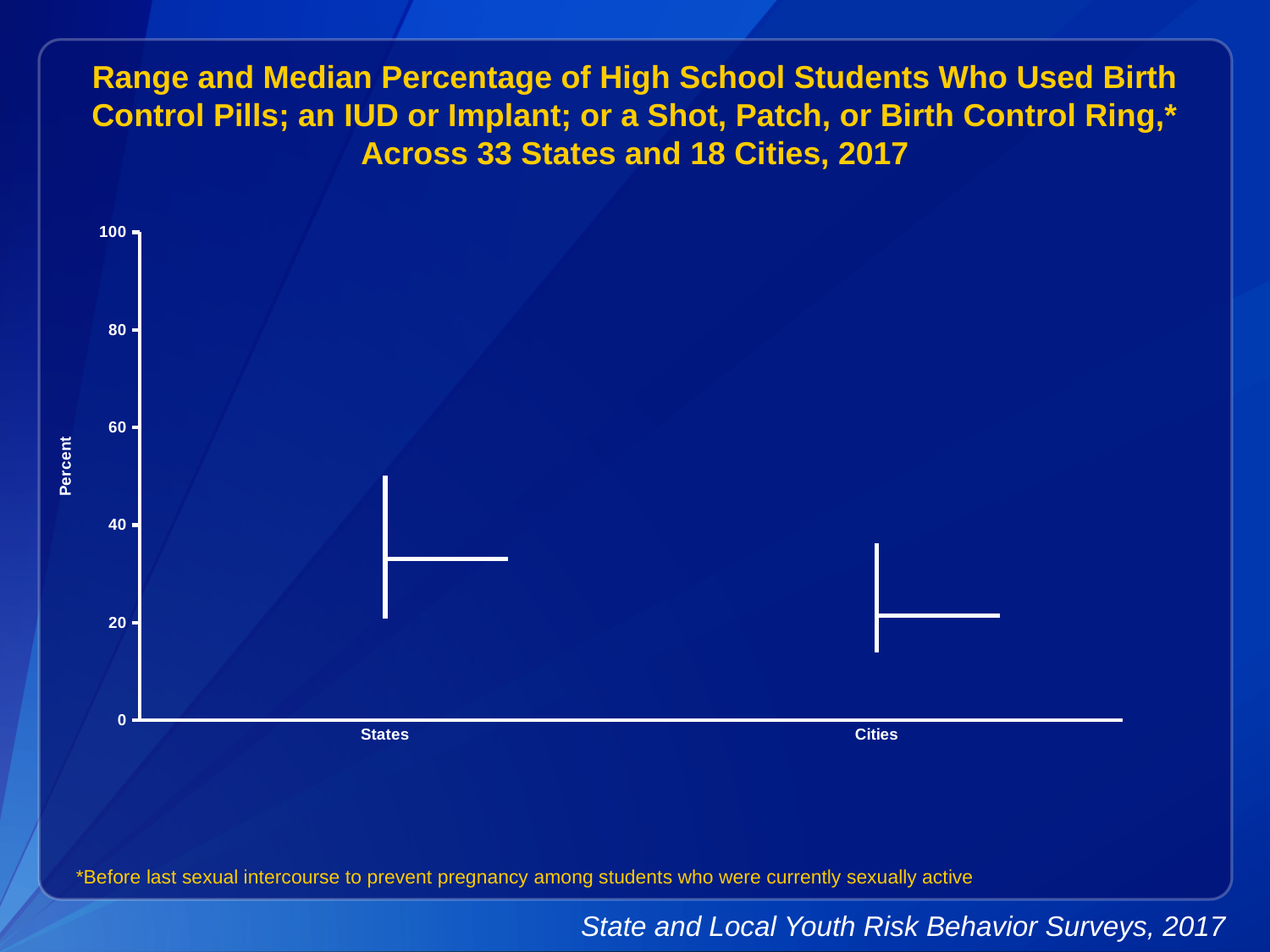
Is the median value for States greater or less than 20? greater Is the median value for States greater or less than 40? less Which category has the higher top of its range, States or Cities? States Is the top of the range for States greater or less than 40? greater Which category has the higher median percentage, States or Cities? States What is the highest value shown on the y axis of the chart? 100 What is the label on the y axis of the chart? Percent How many categories are shown on the x axis of the chart? 2